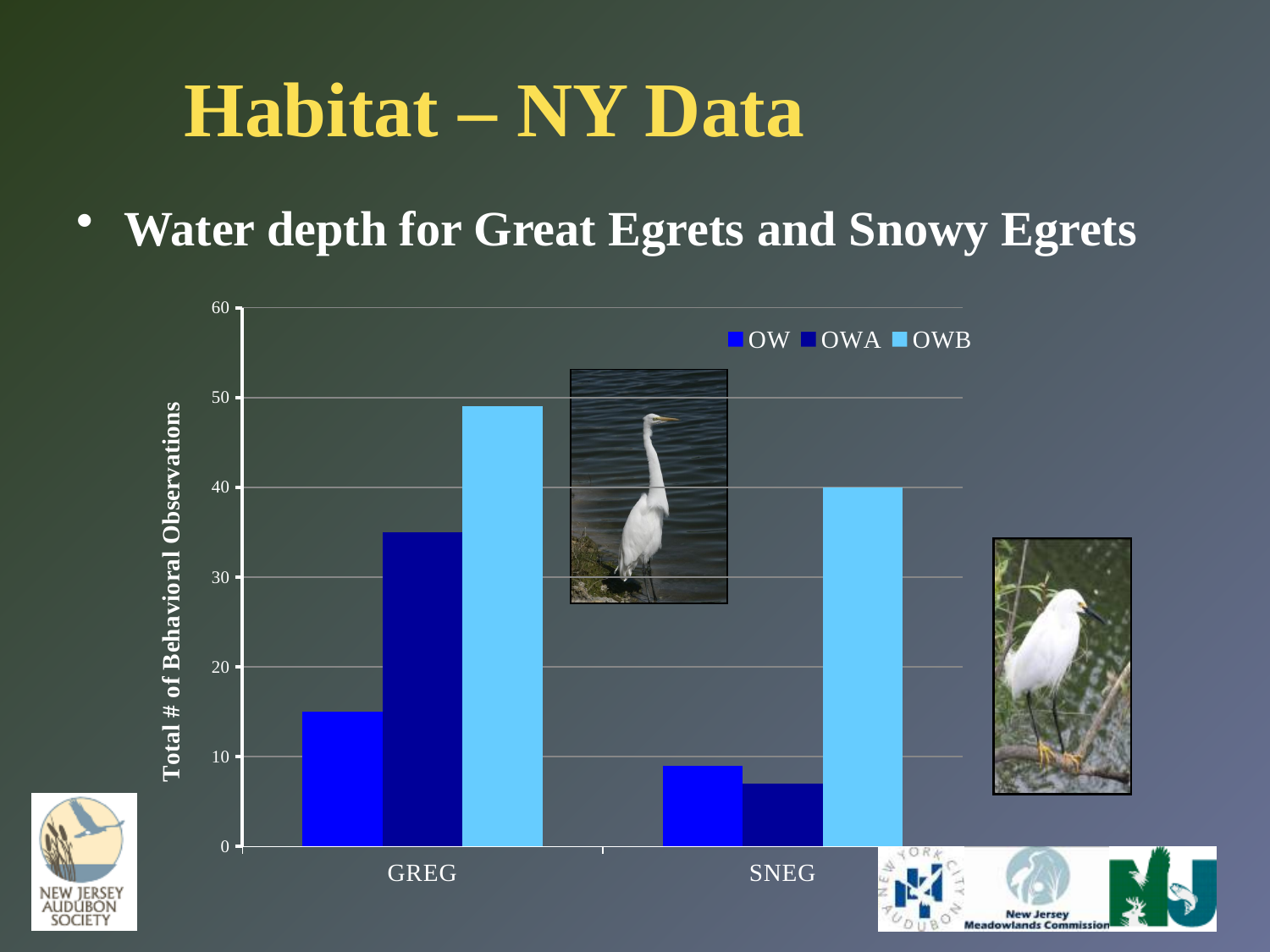
What is the label of the y axis of the chart? Total # of Behavioral Observations Is the OW value for GREG greater or less than 20? less How many categories are shown on the x axis of the chart? 2 Which series has the highest value for SNEG? OWB Which series is shown in light blue in the chart legend? OWB Which is larger, the OWA value for GREG or the OWA value for SNEG? GREG Which series has the highest value for GREG? OWB Is the OWA value for SNEG greater or less than 10? less How many series does the chart legend list? 3 Which series has the lowest value for GREG? OW What kind of chart is shown on the slide? bar chart Is the OWB value for GREG greater or less than 40? greater